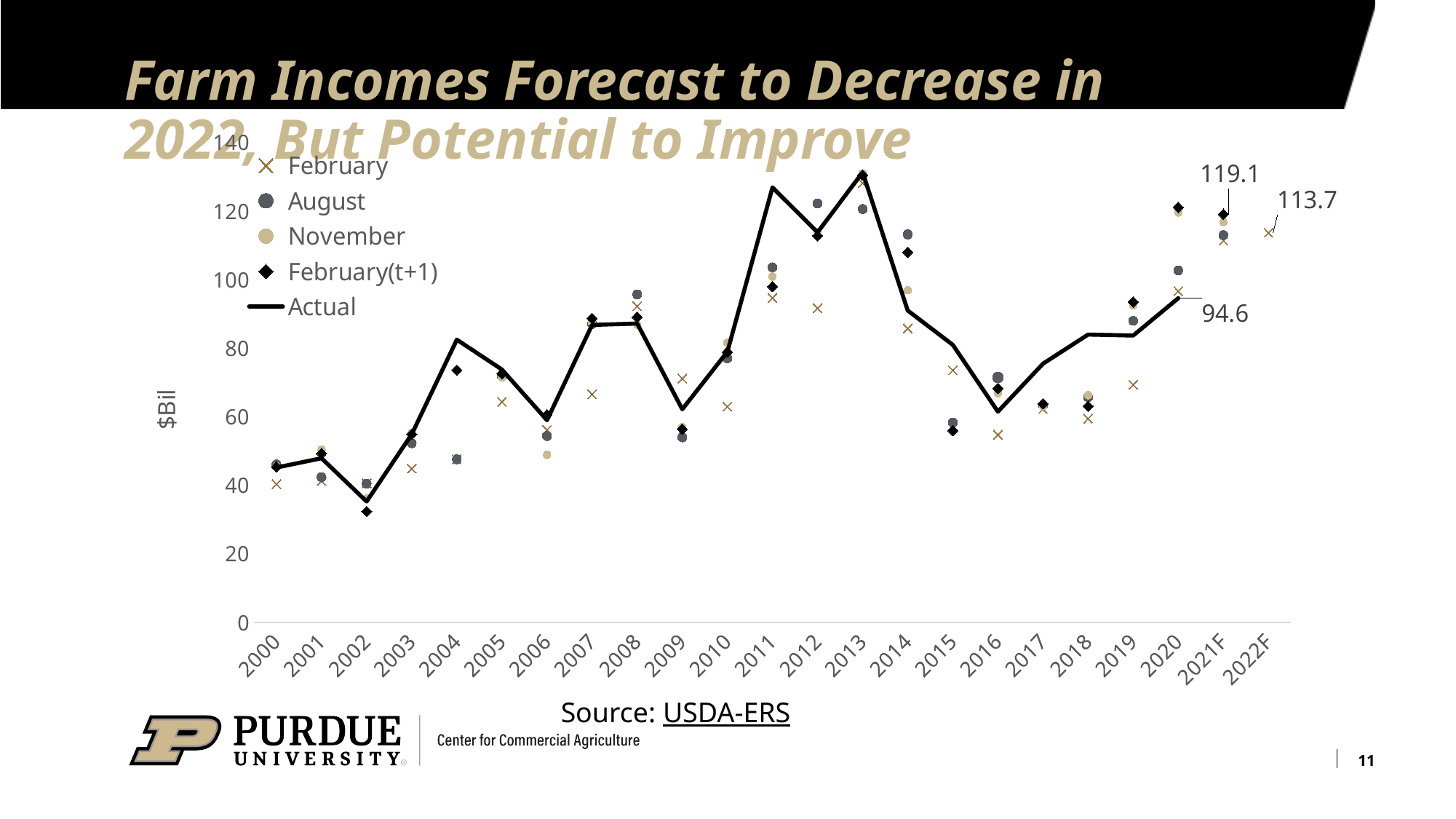
Is the Actual value for 2002 greater or less than 40? less Which is larger: the 2021F February(t+1) value or the 2022F February value? 2021F February(t+1) What is the difference between the 2021F February(t+1) value (119.1) and the 2022F February value (113.7)? 5.4 What is the February(t+1) value for 2021F? 119.1 Is the Actual value for 2013 greater or less than 120? greater What is the Actual value for 2020? 94.6 What is the February value for 2022F? 113.7 How many years are shown on the x axis? 23 How many series does the legend list? 5 What kind of chart is this? Line chart In which year does the Actual line reach its highest value? 2013 What is the label on the y axis? $Bil